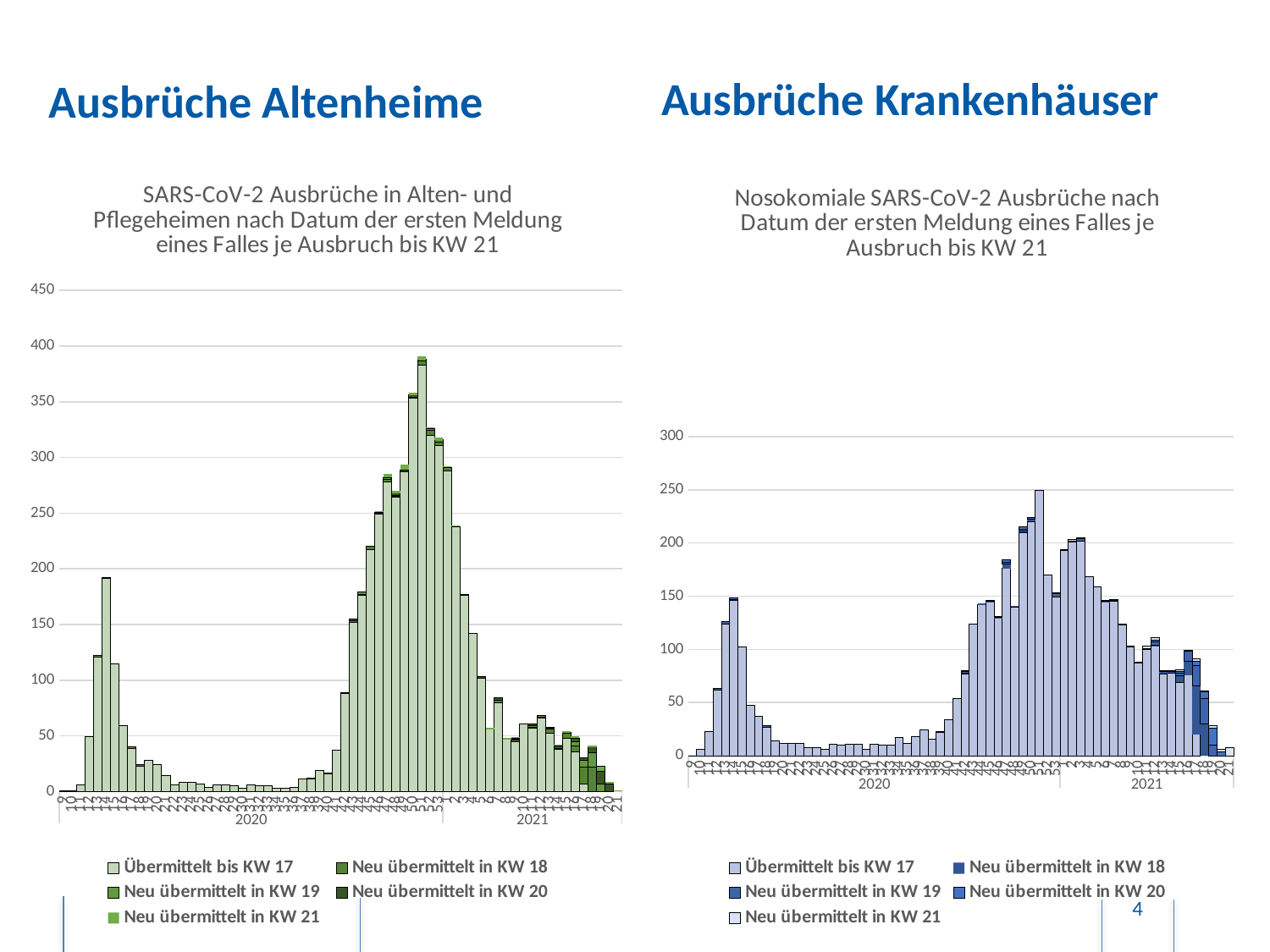
What kind of chart is the right chart, 'Nosokomiale SARS-CoV-2 Ausbrüche'? Stacked bar chart What kind of chart is the left chart, 'SARS-CoV-2 Ausbrüche in Alten- und Pflegeheimen'? Stacked bar chart How many series does the legend of the right chart (Nosokomiale Ausbrüche) list? 5 In the right chart (Nosokomiale Ausbrüche), is the highest bar in the early 2020 peak greater or less than 100? greater Which legend entry in the left chart (Alten- und Pflegeheime) is listed first? Übermittelt bis KW 17 In the right chart (Nosokomiale Ausbrüche), is the value of the tallest bar greater or less than 300? less What is the highest value shown on the y axis of the right chart (Nosokomiale Ausbrüche)? 300 In the left chart (Alten- und Pflegeheime), is the highest bar in the early 2020 peak greater or less than 150? greater How many series does the legend of the left chart (Alten- und Pflegeheime) list? 5